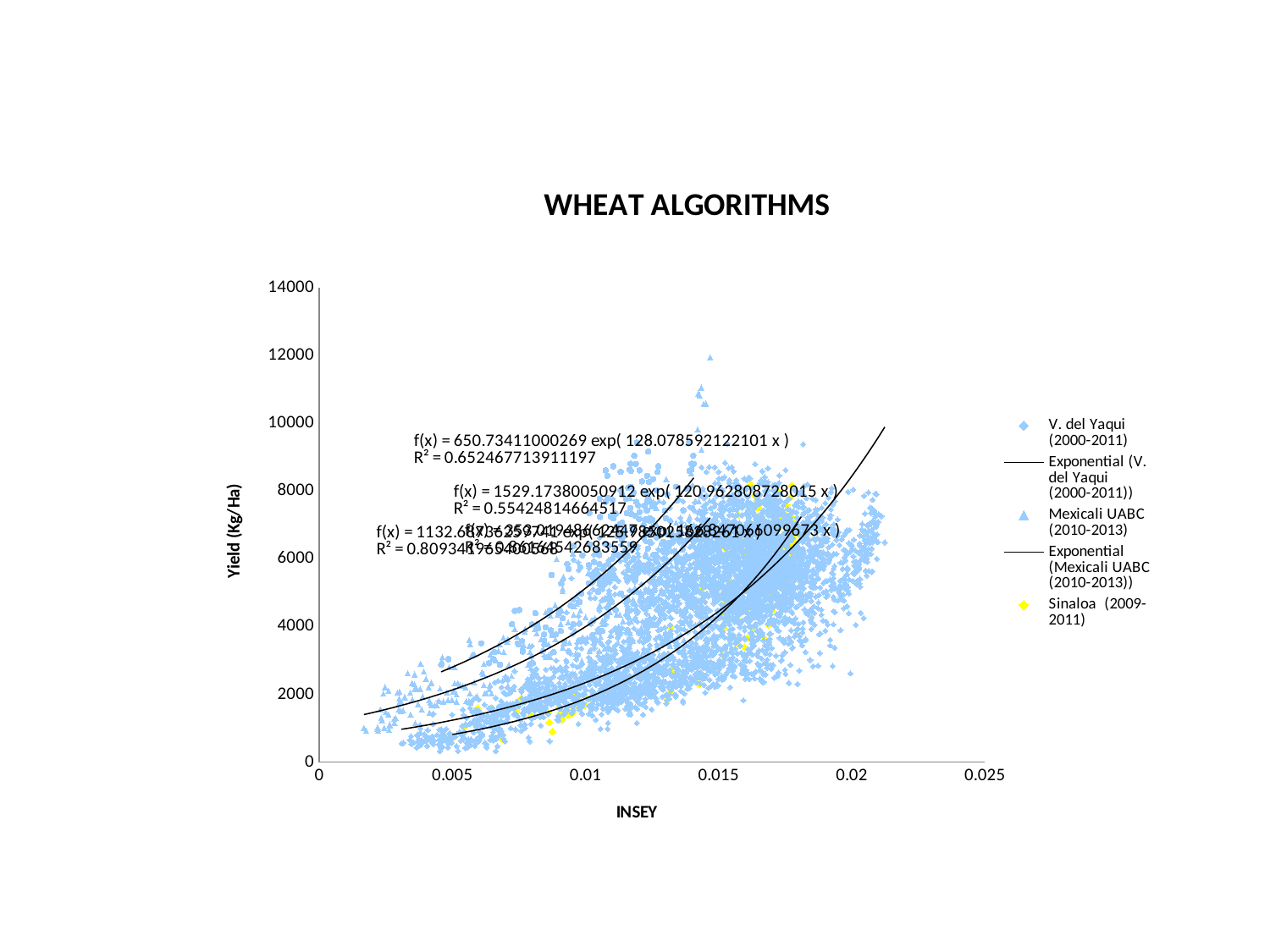
What is the highest value labelled on the y axis? 14000 What is the R² value shown for the trendline f(x) = 650.73411000269 exp( 128.078592122101 x )? 0.652467713911197 Which series is plotted with yellow markers? Sinaloa (2009-2011) How many entries does the chart legend list? 5 Which series contains the single highest yield point on the chart? Mexicali UABC (2010-2013) What is the title of the chart? WHEAT ALGORITHMS Is the highest Mexicali UABC (2010-2013) point greater or less than 10000 Kg/Ha? greater How many exponential trendline entries does the legend list? 2 What is the R² value shown for the trendline f(x) = 1529.17380050912 exp( 120.962808728015 x )? 0.55424814664517 As INSEY increases along the x axis, does yield generally rise or fall? rise What kind of chart is shown on the slide? scatter chart What is the highest value labelled on the x axis? 0.025